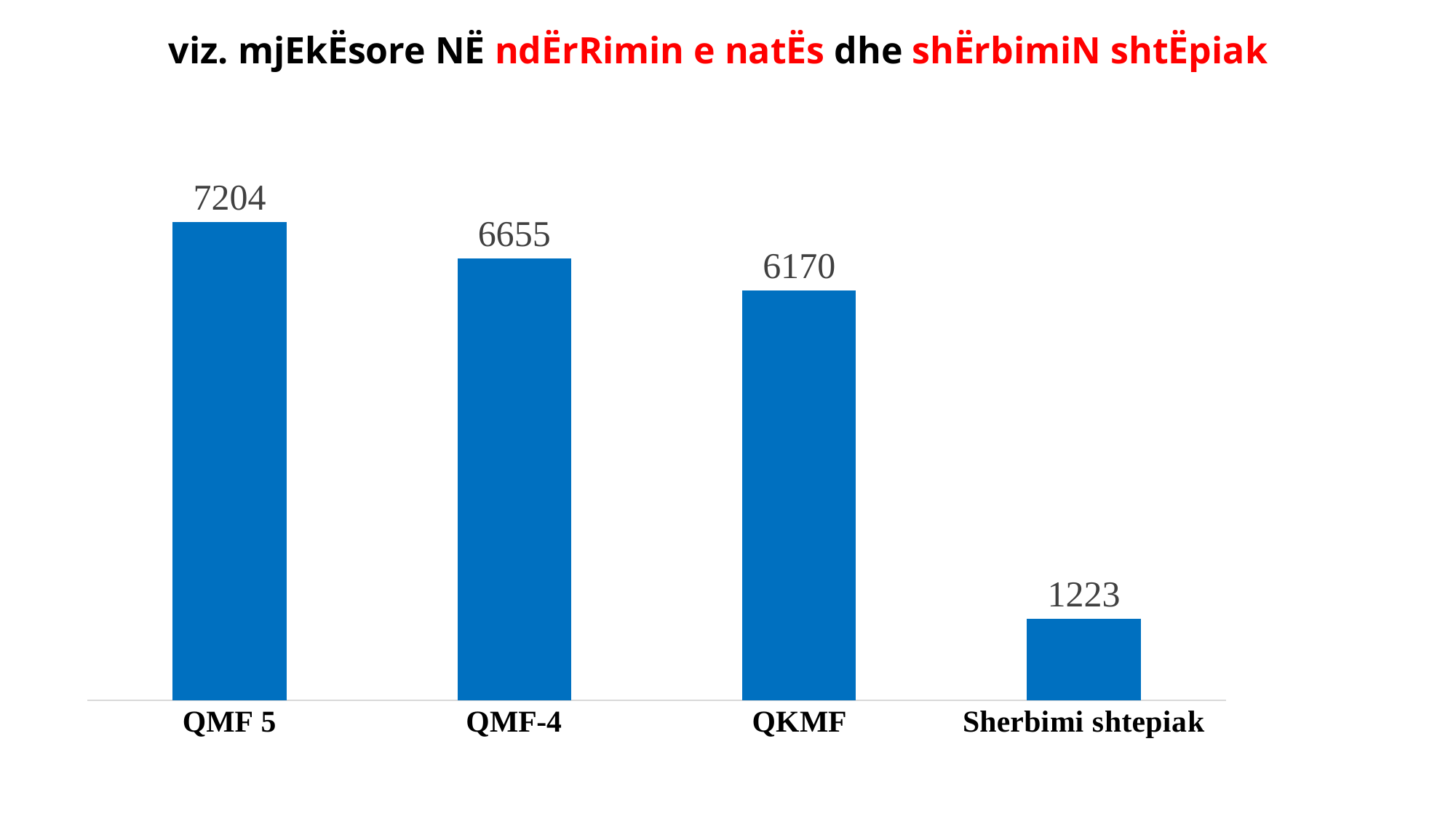
Which is larger, the value for QMF-4 or the value for QKMF? QMF-4 What is the value for Sherbimi shtepiak? 1223 What is the value for QMF 5? 7204 What is the value for QMF-4? 6655 Do the values rise or fall from left to right along the x axis? fall Which category has the highest value? QMF 5 What is the difference between the values for QKMF and Sherbimi shtepiak? 4947 How many categories are shown in the chart? 4 What is the difference between the values for QMF 5 and QMF-4? 549 Which category has the lowest value? Sherbimi shtepiak What is the value for QKMF? 6170 What kind of chart is shown on the slide? bar chart